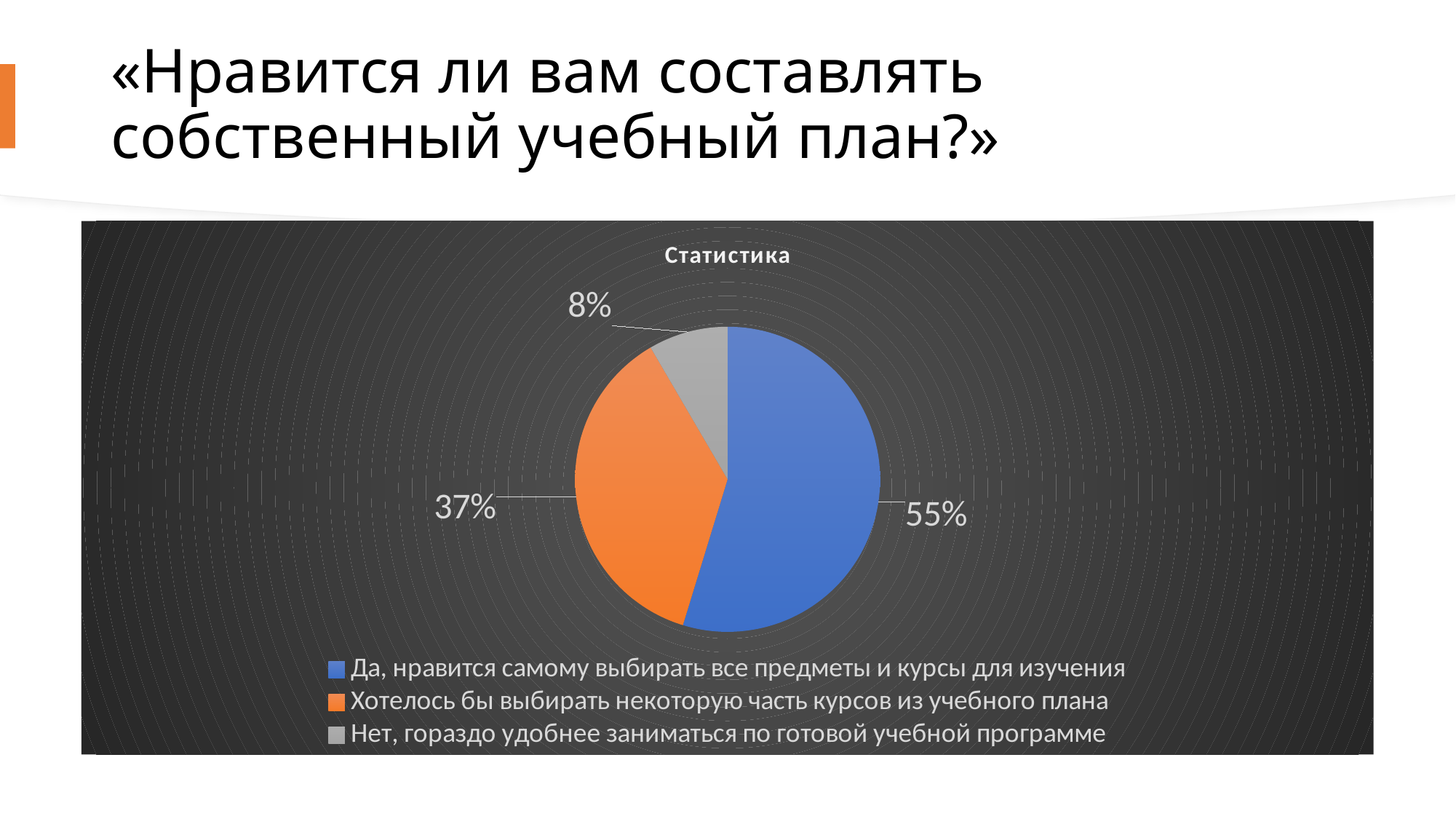
How many slices does the pie chart have? 3 What share of the pie is labelled "Да, нравится самому выбирать все предметы и курсы для изучения"? 55% What share of the pie is labelled "Хотелось бы выбирать некоторую часть курсов из учебного плана"? 37% How many entries does the legend list? 3 What colour is the slice for "Нет, гораздо удобнее заниматься по готовой учебной программе"? grey Which category has the smallest slice of the pie? Нет, гораздо удобнее заниматься по готовой учебной программе Which category has the largest slice of the pie? Да, нравится самому выбирать все предметы и курсы для изучения What kind of chart is shown on the slide? pie chart What is the chart's title? Статистика What share of the pie is labelled "Нет, гораздо удобнее заниматься по готовой учебной программе"? 8% What is the difference in percentage points between the "Да, нравится самому выбирать все предметы и курсы для изучения" slice and the "Хотелось бы выбирать некоторую часть курсов из учебного плана" slice? 18% Which is larger: the "Хотелось бы выбирать некоторую часть курсов из учебного плана" slice or the "Нет, гораздо удобнее заниматься по готовой учебной программе" slice? Хотелось бы выбирать некоторую часть курсов из учебного плана